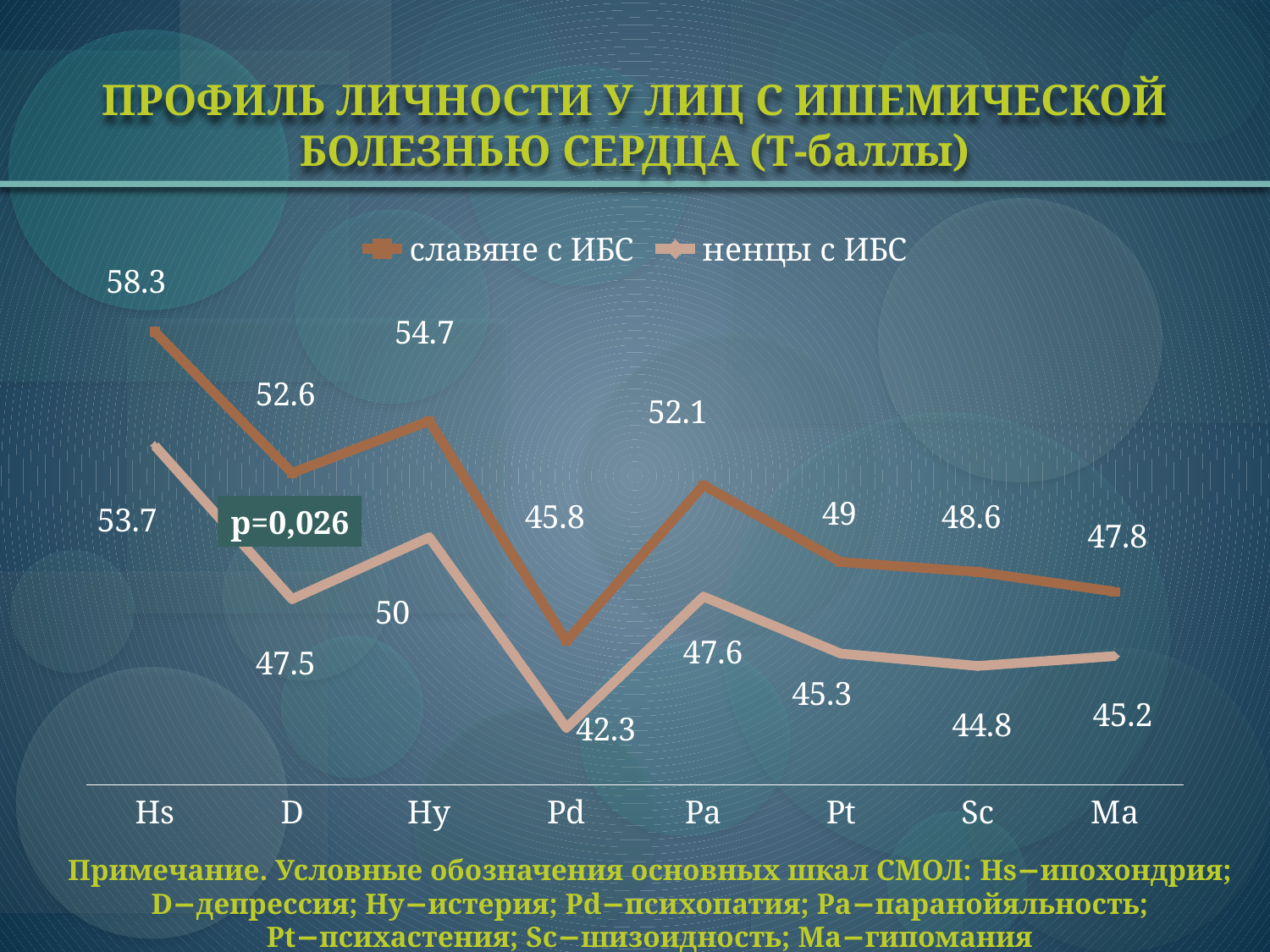
Do the values of the series 'славяне с ИБС' rise or fall from Pt to Ma? fall Which category has the lowest value in the series 'ненцы с ИБС'? Pd What is the value for Hs in the series 'славяне с ИБС'? 58.3 How many series does the legend list? 2 What p-value is printed on the chart? p=0,026 How many categories are shown on the x axis? 8 What type of chart is shown on the slide? line chart Which category has the highest value in the series 'славяне с ИБС'? Hs What is the value for Pa in the series 'славяне с ИБС'? 52.1 What is the difference between the 'славяне с ИБС' and 'ненцы с ИБС' values for D? 5.1 What is the value for Pd in the series 'ненцы с ИБС'? 42.3 Which series has the larger value for Sc, 'славяне с ИБС' or 'ненцы с ИБС'? славяне с ИБС